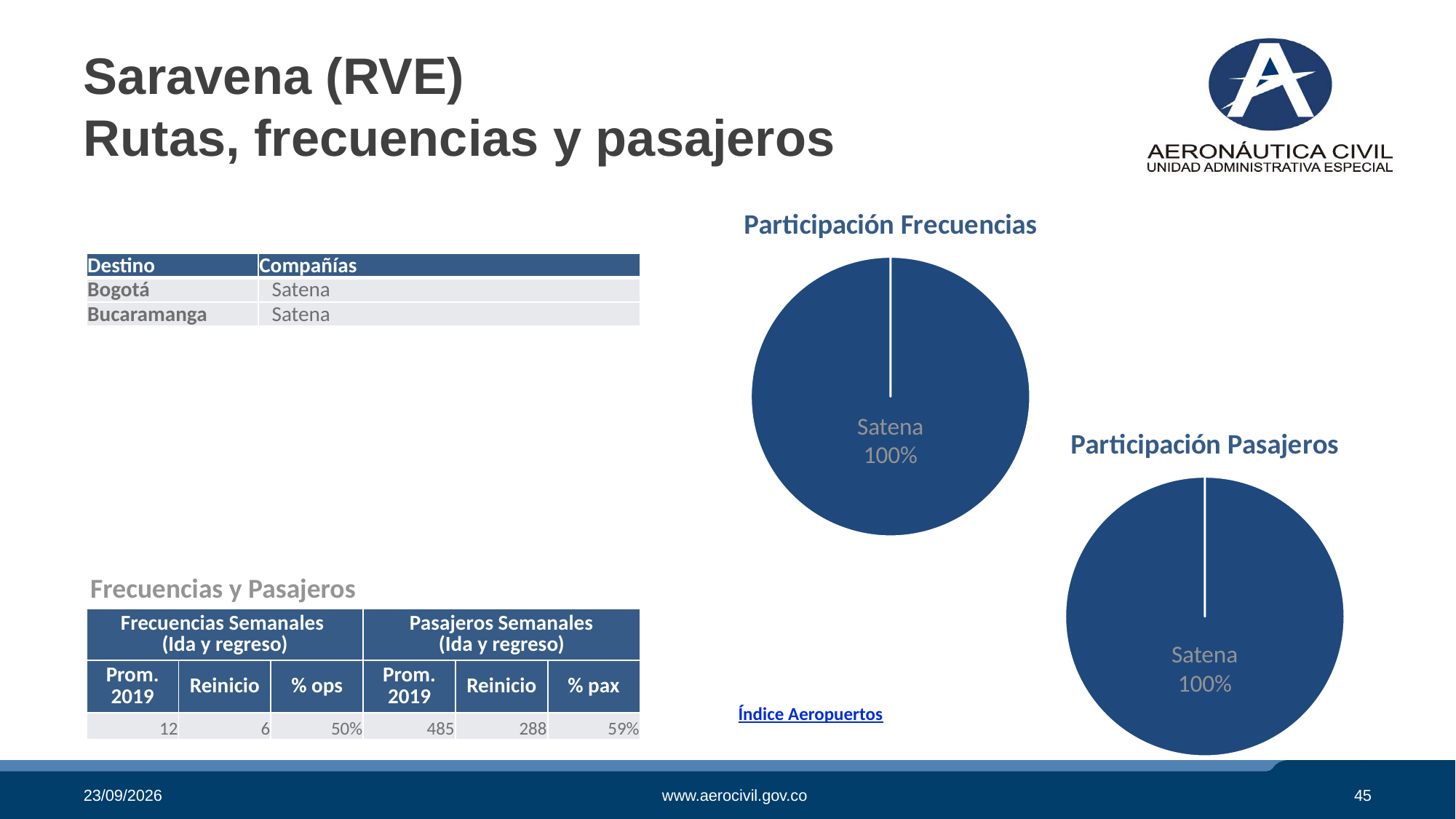
How many pie charts are shown on the slide? 2 How many slices does the 'Participación Frecuencias' pie chart have? 1 In the 'Participación Pasajeros' chart, what share of the pie does Satena hold? 100% In the 'Participación Frecuencias' chart, what share of the pie does Satena hold? 100% Which company is shown in the 'Participación Pasajeros' pie chart? Satena How many slices does the 'Participación Pasajeros' pie chart have? 1 What kind of chart is 'Participación Pasajeros'? Pie chart Which company is shown in the 'Participación Frecuencias' pie chart? Satena What kind of chart is 'Participación Frecuencias'? Pie chart What is the title of the pie chart in the lower right of the slide? Participación Pasajeros What is the title of the pie chart in the upper right of the slide? Participación Frecuencias